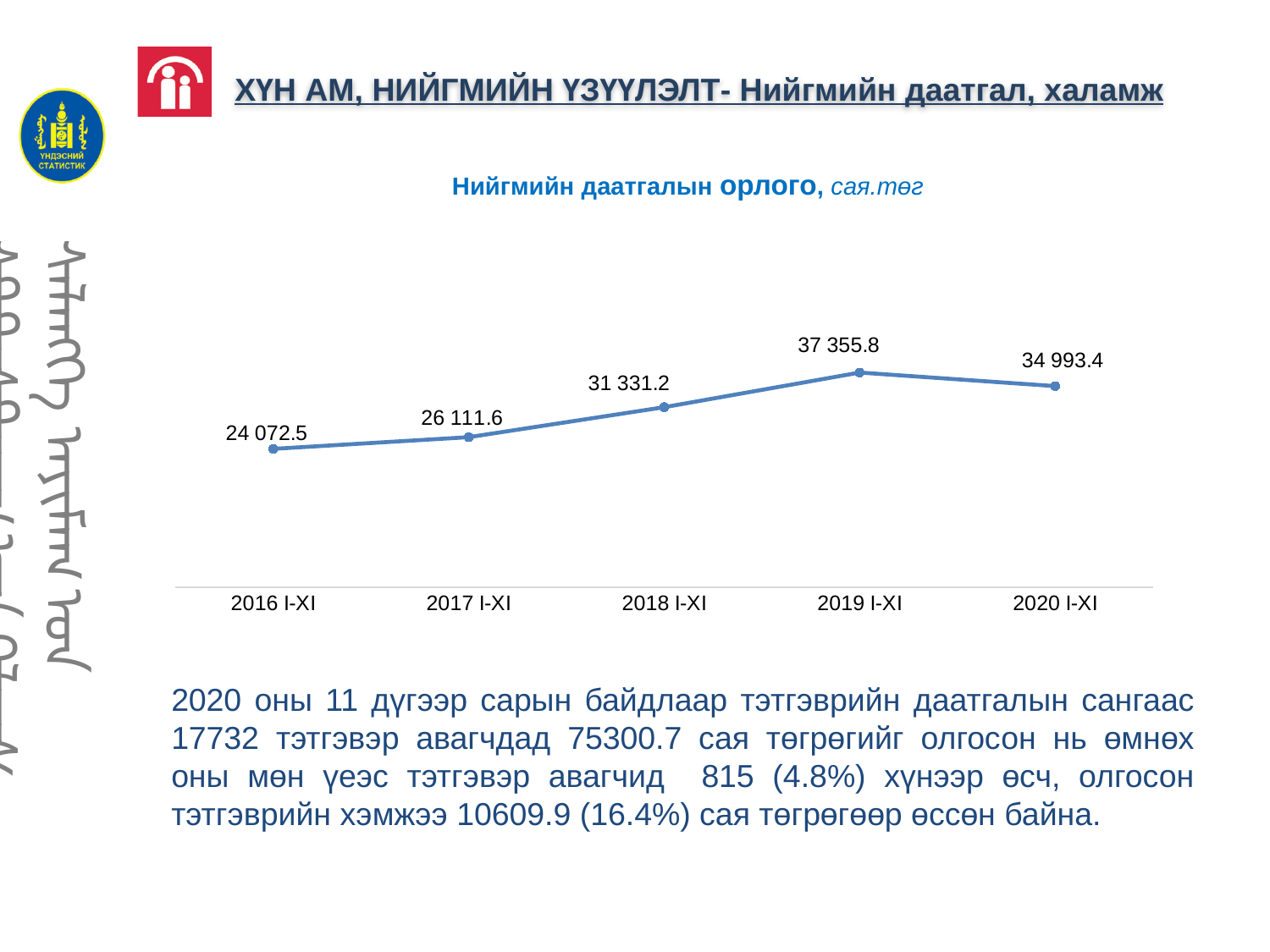
What is the title of the chart? Нийгмийн даатгалын орлого, сая.төг What kind of chart is shown on the slide? Line chart Which period has the lowest value? 2016 I-XI Which is larger, the value for 2017 I-XI or the value for 2020 I-XI? 2020 I-XI What is the value for 2018 I-XI? 31 331.2 What is the difference between the values for 2019 I-XI and 2018 I-XI? 6 024.6 By how much did the value fall from 2019 I-XI to 2020 I-XI? 2 362.4 Which period has the highest value? 2019 I-XI What is the value for 2016 I-XI? 24 072.5 How does the value change from 2016 I-XI to 2019 I-XI? It rises How many data points are plotted on the chart? 5 What is the value for 2020 I-XI? 34 993.4